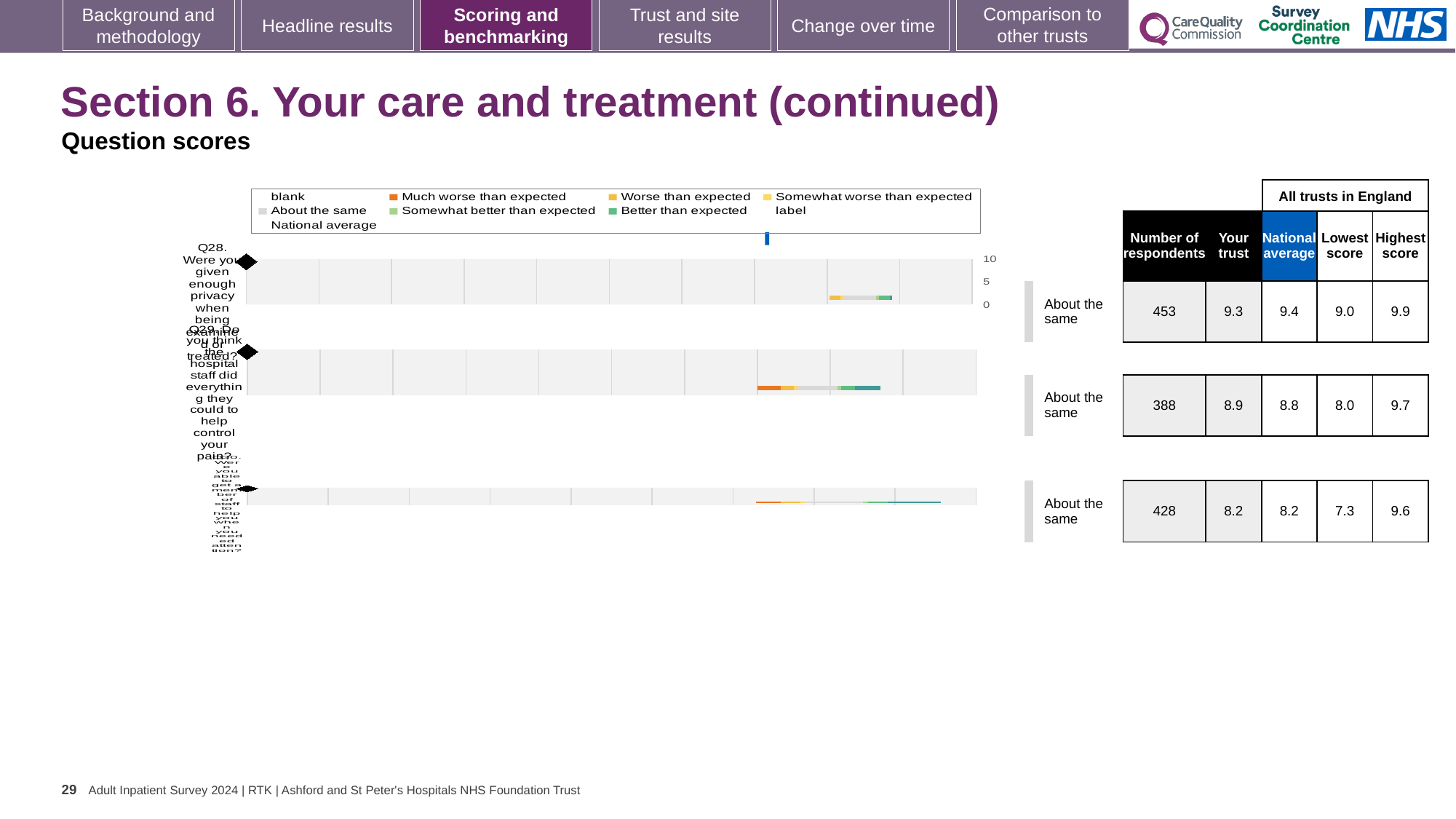
How many respondents answered Q30? 428 What is the difference between the highest score and the lowest score for Q29? 1.7 How many questions (categories) are plotted in the chart? 3 What benchmark category is shown for Q28? About the same What is the highest score among all trusts in England for Q30? 9.6 What kind of chart is shown on the slide? bar chart What is the 'Your trust' score for Q28 (privacy when being examined or treated)? 9.3 What is the national average score for Q29 (staff did everything to help control your pain)? 8.8 What is the lowest score among all trusts in England for Q28? 9.0 Which question has the lowest number of respondents? Q29 Which question has the highest 'Your trust' score? Q28 For Q28, which is larger: the 'Your trust' score or the national average? National average